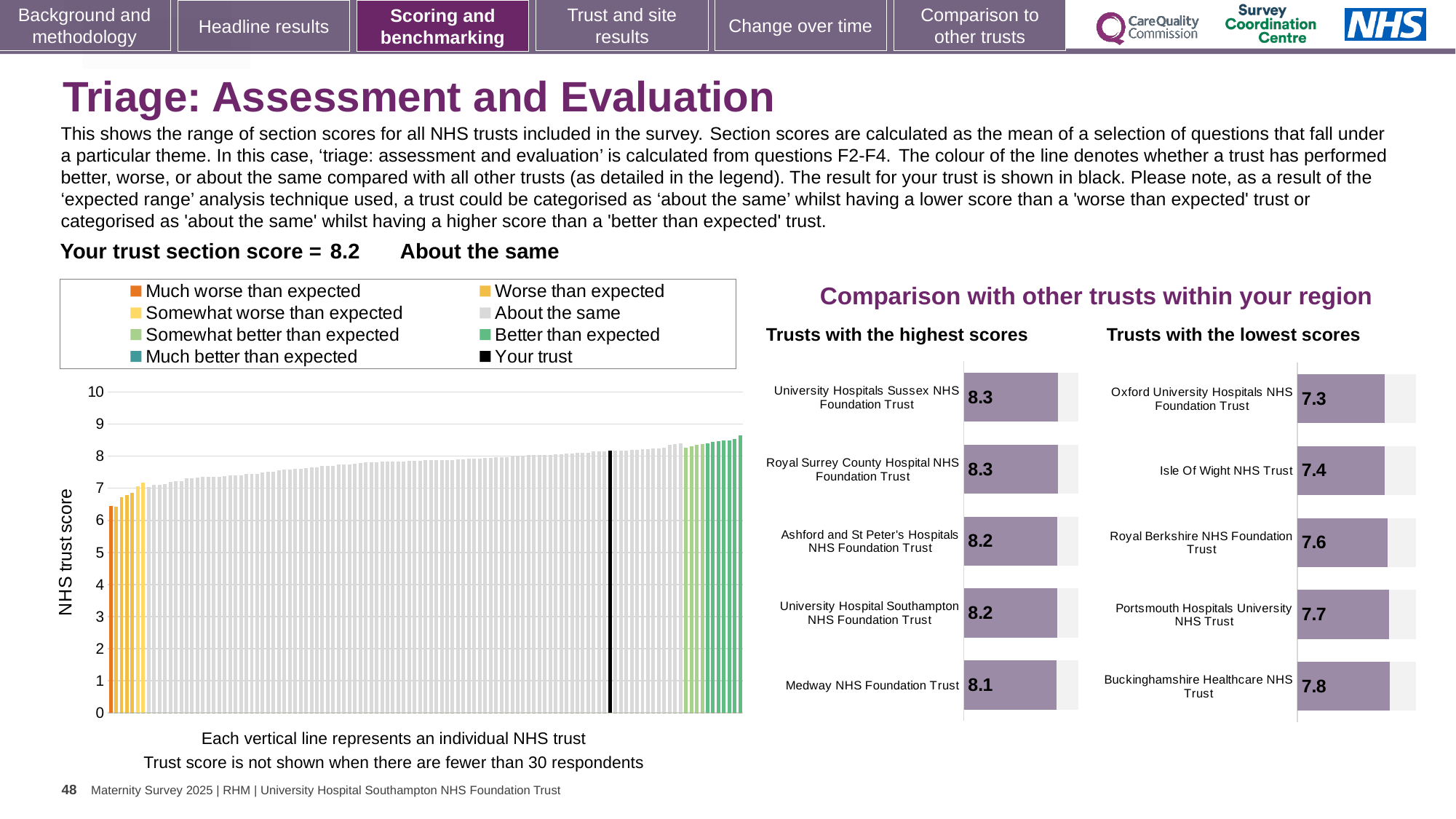
In the main 'NHS trust score' chart on the left, do the bar values rise or fall from left to right? rise In the main 'NHS trust score' chart on the left, is the value of the black 'Your trust' bar greater or less than 8? greater In the 'Trusts with the lowest scores' chart, what is the score for Royal Berkshire NHS Foundation Trust? 7.6 In the main 'NHS trust score' chart on the left, is the value of the lowest (leftmost) bar greater or less than 7? less In the 'Trusts with the highest scores' chart, what is the score for Medway NHS Foundation Trust? 8.1 In the 'Trusts with the lowest scores' chart, which has the larger score: Royal Berkshire NHS Foundation Trust or Portsmouth Hospitals University NHS Trust? Portsmouth Hospitals University NHS Trust In the 'Trusts with the highest scores' chart, which trust has the lowest score? Medway NHS Foundation Trust How many entries does the legend of the main 'NHS trust score' chart list? 8 In the 'Trusts with the lowest scores' chart, which trust has the highest score? Buckinghamshire Healthcare NHS Trust In the 'Trusts with the lowest scores' chart, what is the difference between the scores of Buckinghamshire Healthcare NHS Trust and Oxford University Hospitals NHS Foundation Trust? 0.5 In the 'Trusts with the lowest scores' chart, which trust has the lowest score? Oxford University Hospitals NHS Foundation Trust How many trusts are shown in the 'Trusts with the highest scores' chart? 5